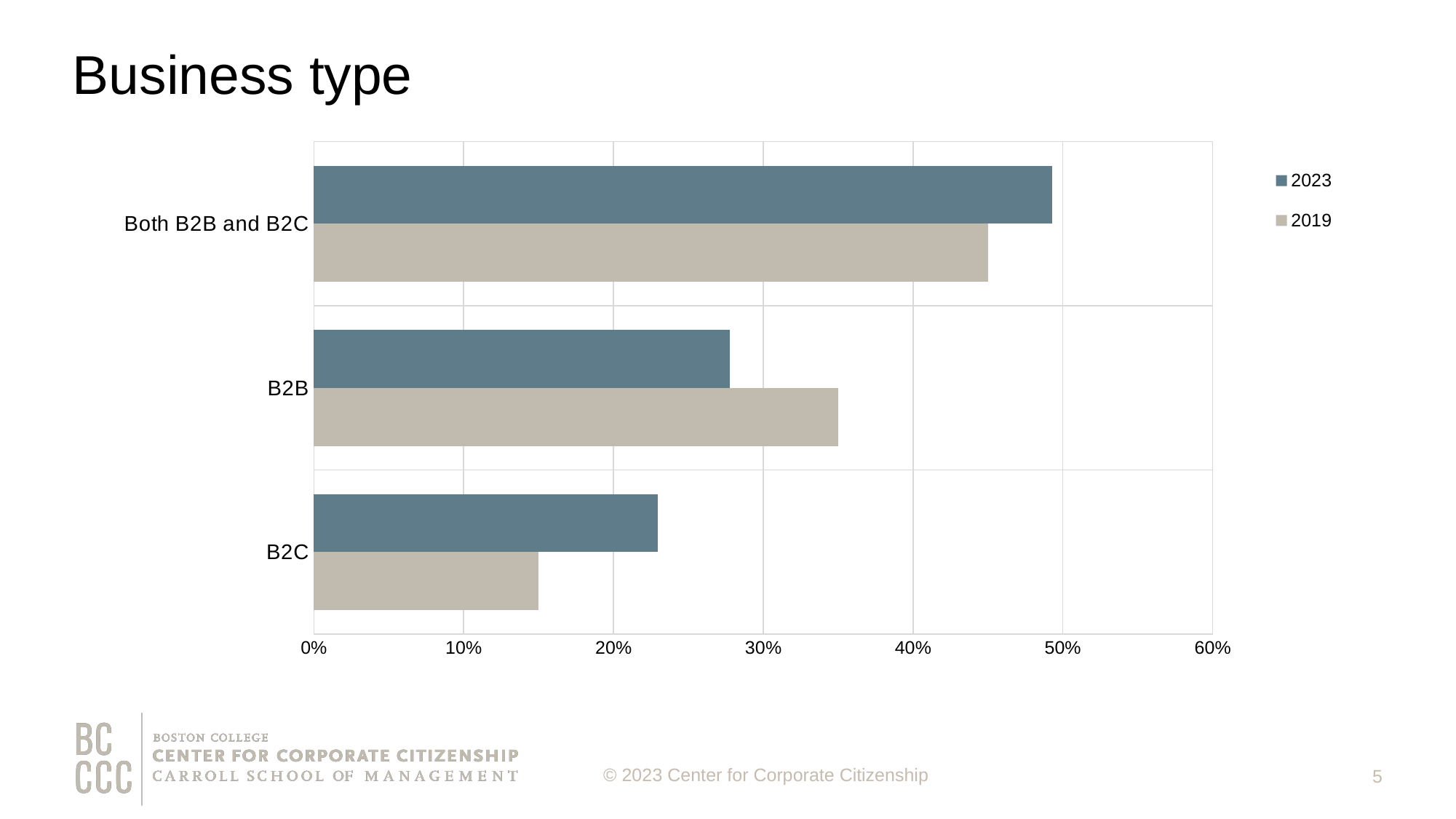
For B2C, which year has the larger value, 2023 or 2019? 2023 Is the 2019 value for B2C greater or less than 20%? less Is the 2019 value for B2B greater or less than 30%? greater Which category has the lowest value for 2023? B2C Which category has the lowest value for 2019? B2C Which category has the highest value for 2023? Both B2B and B2C How many series does the legend list? 2 For B2B, which year has the larger value, 2023 or 2019? 2019 How many business type categories are shown on the chart? 3 What is the title of the slide containing the chart? Business type What kind of chart is shown on the slide? bar chart Is the 2023 value for Both B2B and B2C greater or less than 40%? greater